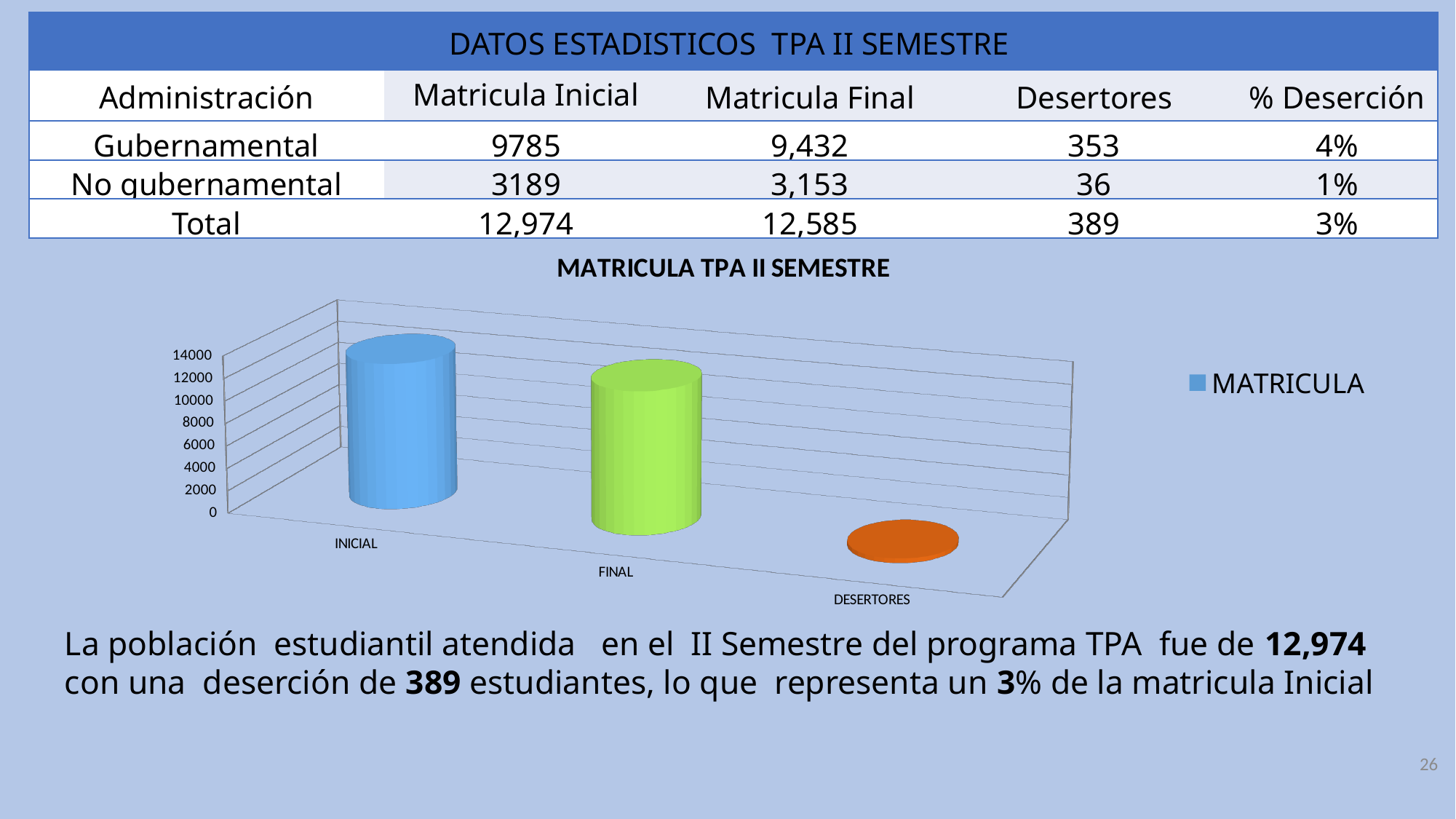
Is the value for FINAL greater or less than 8000? greater Is the value for DESERTORES greater or less than 2000? less How many categories are plotted on the x axis of the chart? 3 Which is larger in the chart, the value for FINAL or the value for DESERTORES? FINAL Is the value for INICIAL greater or less than 10000? greater Which category has the highest bar in the chart? INICIAL Which category has the lowest bar in the chart? DESERTORES What is the title of the chart? MATRICULA TPA II SEMESTRE Do the values rise or fall moving from INICIAL to DESERTORES along the x axis? fall What kind of chart is shown on the slide? bar chart How many series does the chart legend list? 1 What is the name of the series shown in the chart legend? MATRICULA